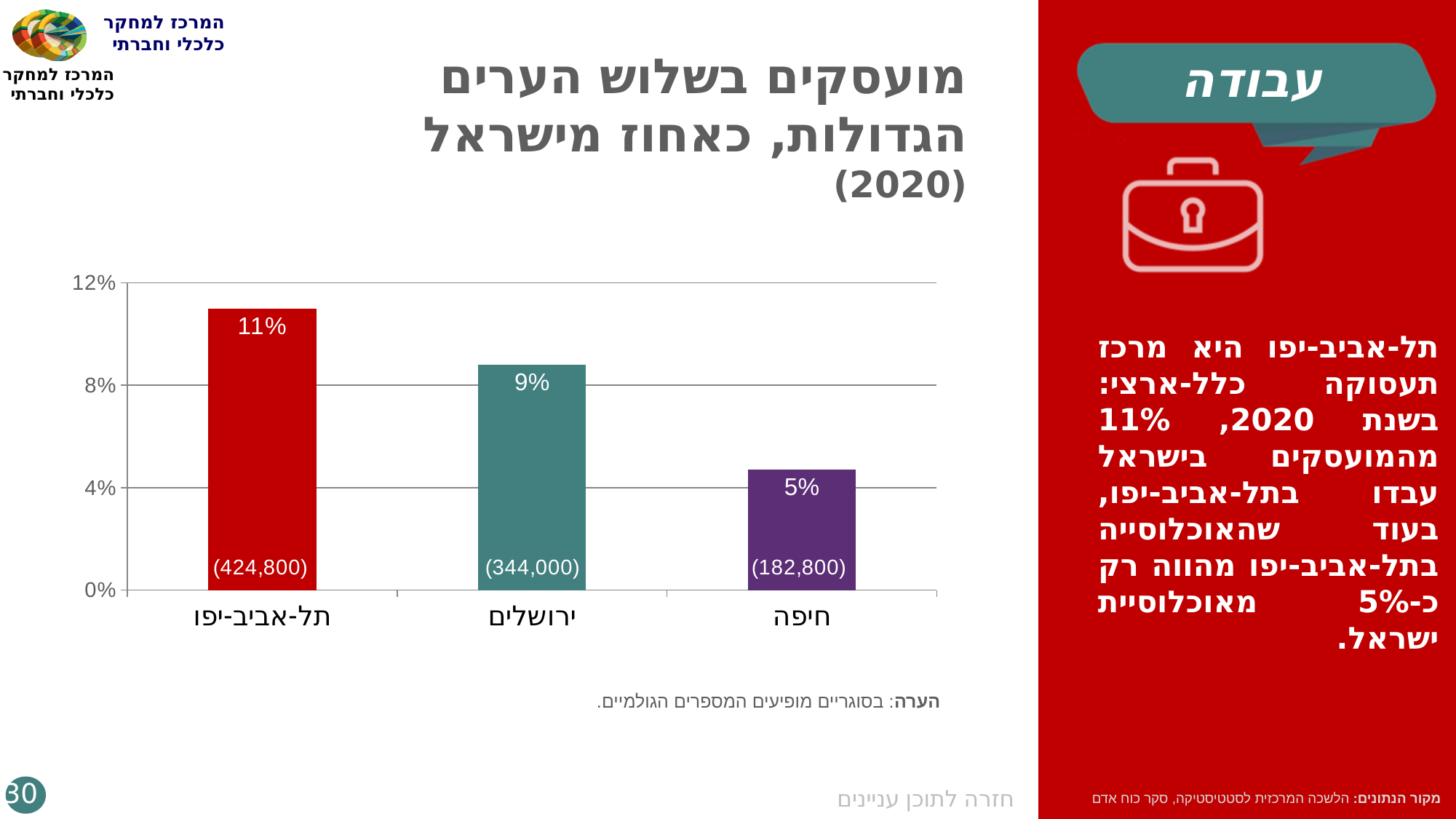
Which city has the highest percentage of employed persons? תל-אביב-יפו Which city has the lowest percentage of employed persons? חיפה How many cities are shown in the chart? 3 What percentage is shown for ירושלים? 9% Which is larger, the value for ירושלים or the value for חיפה? ירושלים What absolute number is printed in parentheses on the bar for חיפה? (182,800) What percentage is shown for תל-אביב-יפו? 11% What type of chart is shown on the slide? bar chart What absolute number is printed in parentheses on the bar for ירושלים? (344,000) What percentage is shown for חיפה? 5% What is the difference in percentage points between תל-אביב-יפו and חיפה? 6% Is the value for ירושלים greater or less than 8%? greater